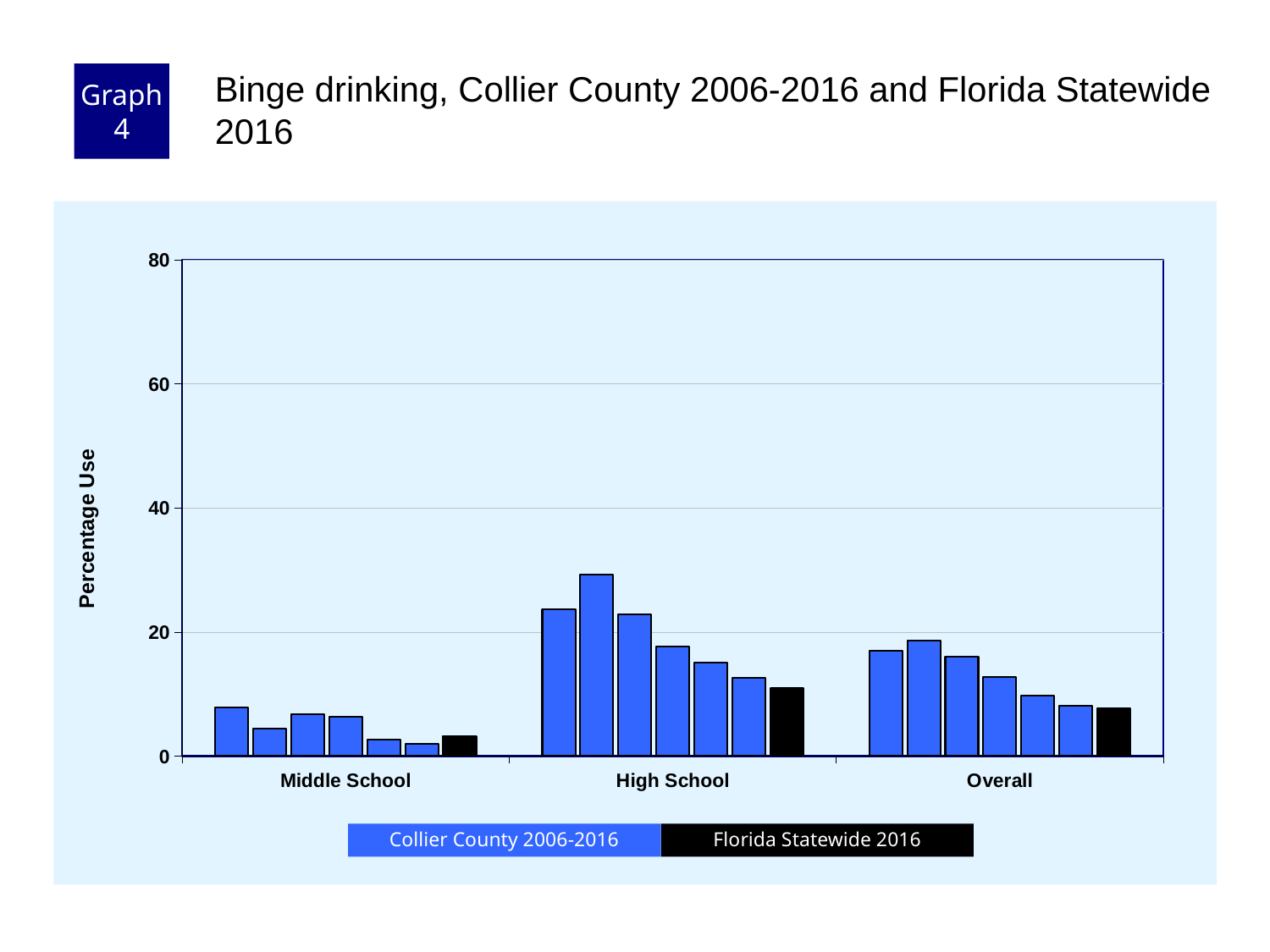
What colour represents Florida Statewide 2016 in the legend? black Which is larger, the Florida Statewide 2016 bar for High School or the Florida Statewide 2016 bar for Middle School? High School What is the label on the y axis? Percentage Use What kind of chart is shown on the slide? bar chart Which category has the tallest bars? High School Which category has the shortest bars? Middle School Is the Florida Statewide 2016 value for High School greater or less than 20? less Is the tallest Collier County bar in the High School group greater or less than 20? greater Is the Florida Statewide 2016 value for Middle School greater or less than 20? less How many school-level categories are shown on the x axis? 3 Within the High School group, do the Collier County bars rise or fall from the second bar to the last bar? fall How many series does the legend list? 2